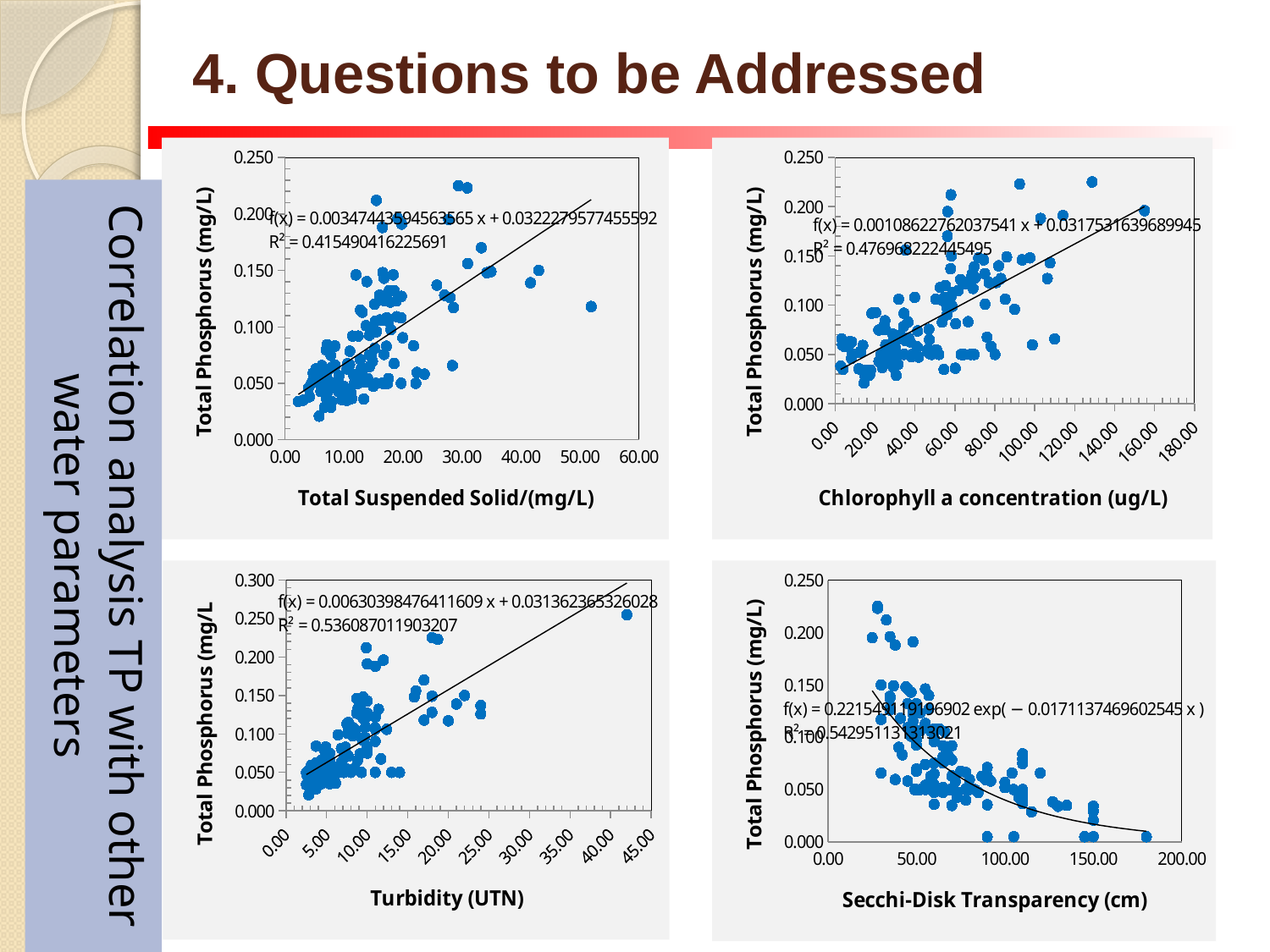
How many charts are shown on the slide? 4 What is the intercept of the fitted line printed on the bottom-left chart (Turbidity)? 0.031362365326028 What is the y-axis title of the top-right chart? Total Phosphorus (mg/L) In the bottom-left chart (Turbidity), is the highest plotted Total Phosphorus value greater or less than 0.200? greater In the bottom-right chart (Secchi-Disk Transparency), do the Total Phosphorus values rise or fall as transparency increases? fall In the top-right chart (Chlorophyll a concentration), does the fitted trendline rise or fall along the x axis? rise What is the R² value printed on the bottom-left chart (Turbidity)? 0.536087011903207 In the bottom-left chart (Turbidity), do the Total Phosphorus values rise or fall as turbidity increases? rise What is the R² value printed on the top-left chart (Total Suspended Solid)? 0.415490416225691 In the bottom-right chart (Secchi-Disk Transparency), is the Total Phosphorus value of the point at the far right (near 180 cm) greater or less than 0.050? less What kind of chart is the top-left chart with the x axis 'Total Suspended Solid/(mg/L)'? scatter chart What is the x-axis title of the bottom-right chart? Secchi-Disk Transparency (cm)